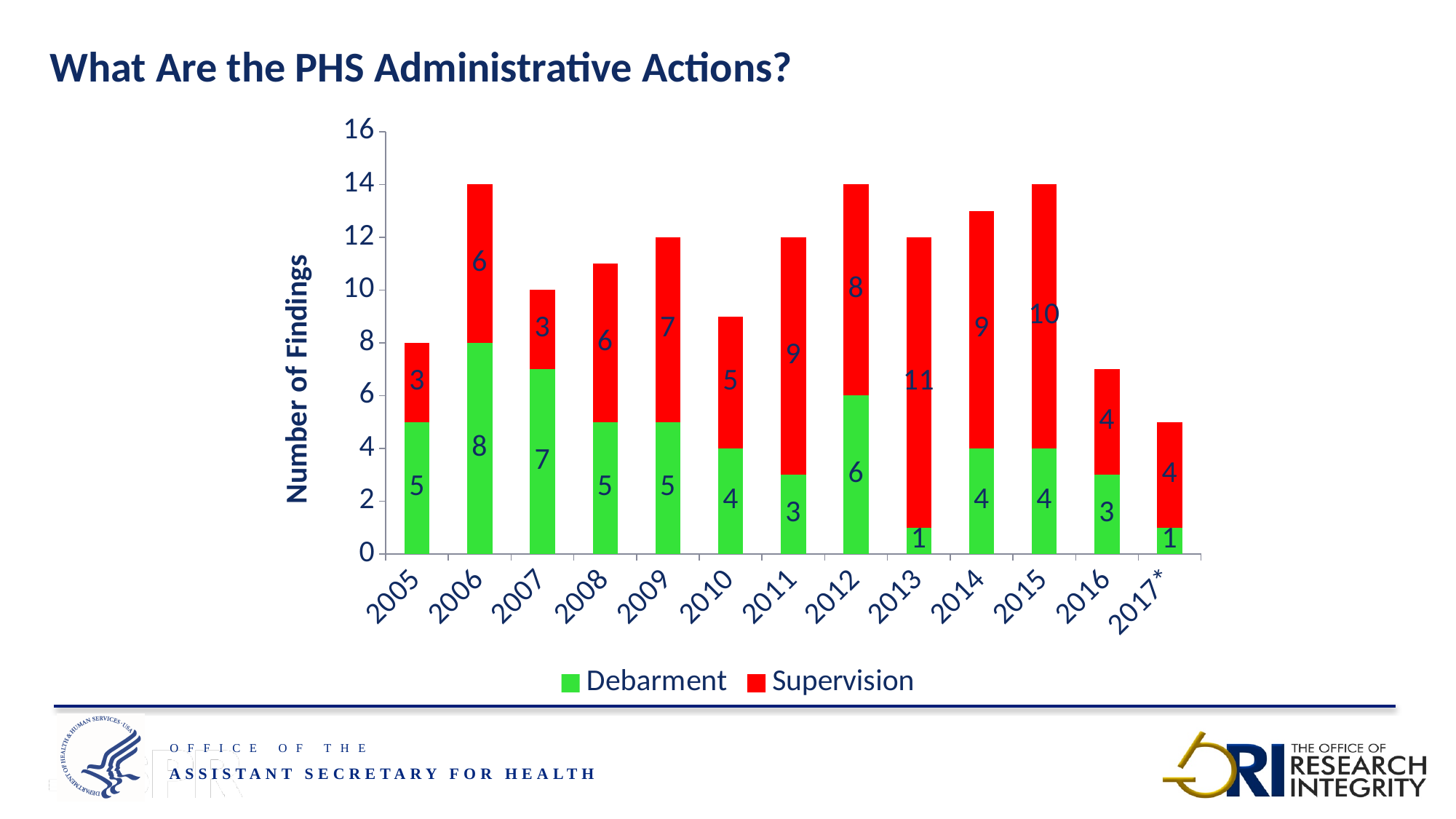
What is the total number of findings for 2014? 13 What is the Supervision value for 2013? 11 Which year has the highest Supervision value? 2013 What is the difference between the Supervision and Debarment values in 2011? 6 What is the Debarment value for 2006? 8 How many series does the legend list? 2 Which is larger in 2012, Debarment or Supervision? Supervision What is the Debarment value for 2017*? 1 How many years are shown on the x axis? 13 Which year has the lowest total number of findings? 2017* What type of chart is shown on the slide? Stacked bar chart Which year has the highest Debarment value? 2006